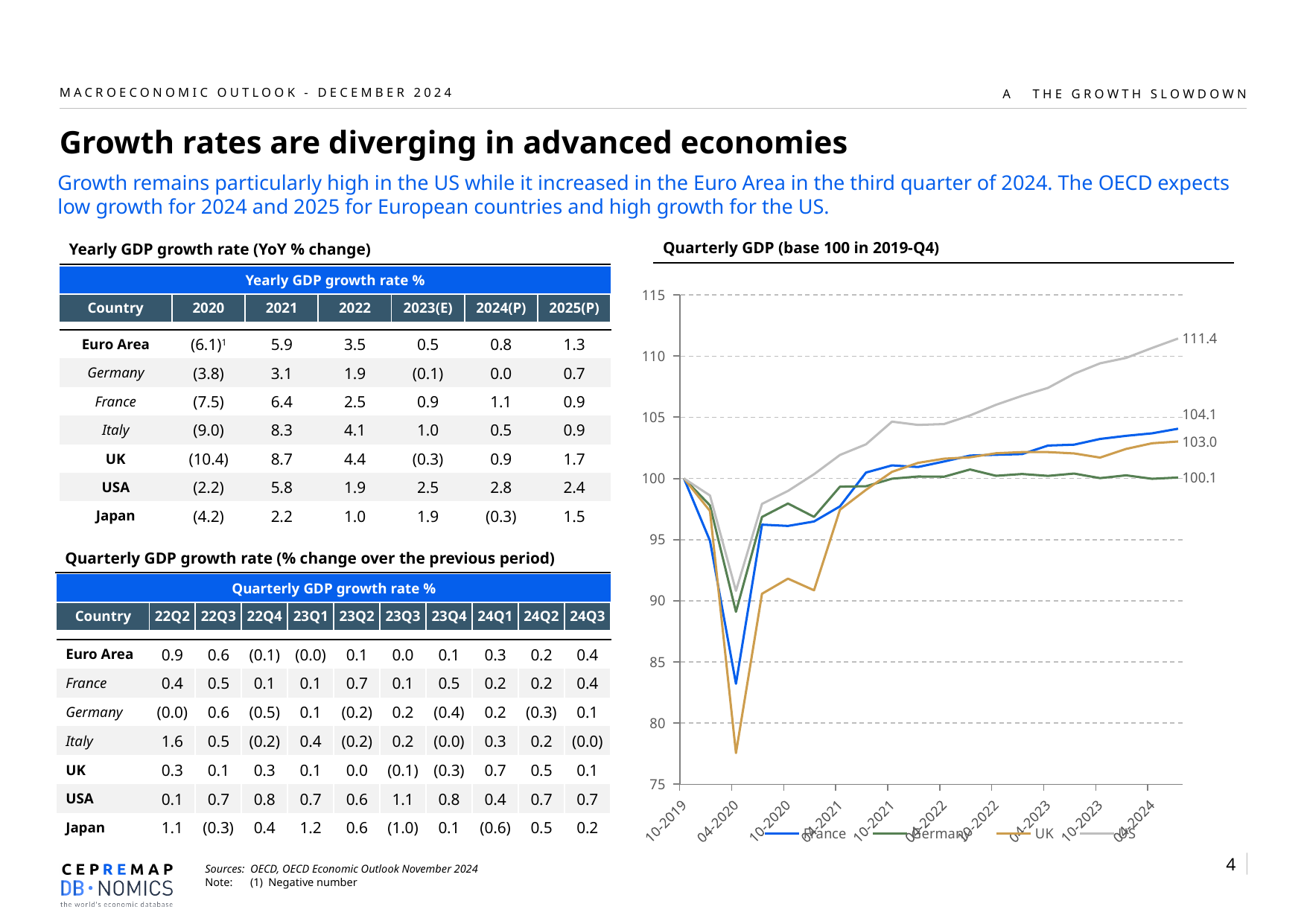
What is the final labelled value of the Germany series in the Quarterly GDP chart? 100.1 In the Quarterly GDP chart, does the US series rise or fall from 10-2020 to the end of the series? rise In the Quarterly GDP chart, which series ends higher, France or UK? France What is the final labelled value of the France series in the Quarterly GDP chart? 104.1 How many series does the legend of the Quarterly GDP chart list? 4 What is the final labelled value of the US series in the Quarterly GDP chart? 111.4 What type of chart is the Quarterly GDP chart? line chart What is the final labelled value of the UK series in the Quarterly GDP chart? 103.0 In the Quarterly GDP chart, what is the difference between the final labelled values of the US and France series? 7.3 Which series ends at the lowest value in the Quarterly GDP chart? Germany Which series ends at the highest value in the Quarterly GDP chart? US In the Quarterly GDP chart, is the value for the UK series at 04-2020 greater or less than 80? less